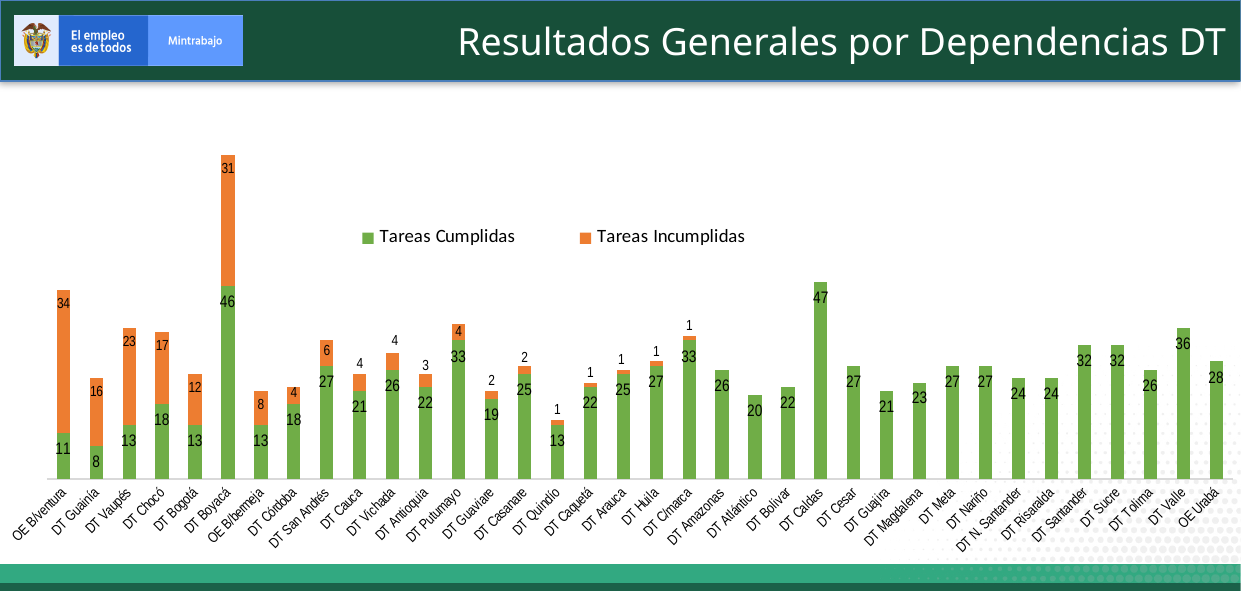
What is the value of Tareas Incumplidas for OE B/ventura? 34 Which dependency has the highest value of Tareas Cumplidas? DT Caldas What type of chart is shown on the slide? Stacked bar chart Which dependency has the lowest value of Tareas Cumplidas? DT Guainía What are the two series named in the legend? Tareas Cumplidas and Tareas Incumplidas What is the total of the stacked bar for DT Boyacá? 77 What is the value of Tareas Cumplidas for DT Boyacá? 46 What is the difference between Tareas Cumplidas for DT Caldas and DT Santander? 15 How many series does the legend list? 2 Which dependency has the highest value of Tareas Incumplidas? OE B/ventura What is the value of Tareas Cumplidas for DT Valle? 36 Which is larger, Tareas Incumplidas for DT Vaupés or for DT Chocó? DT Vaupés